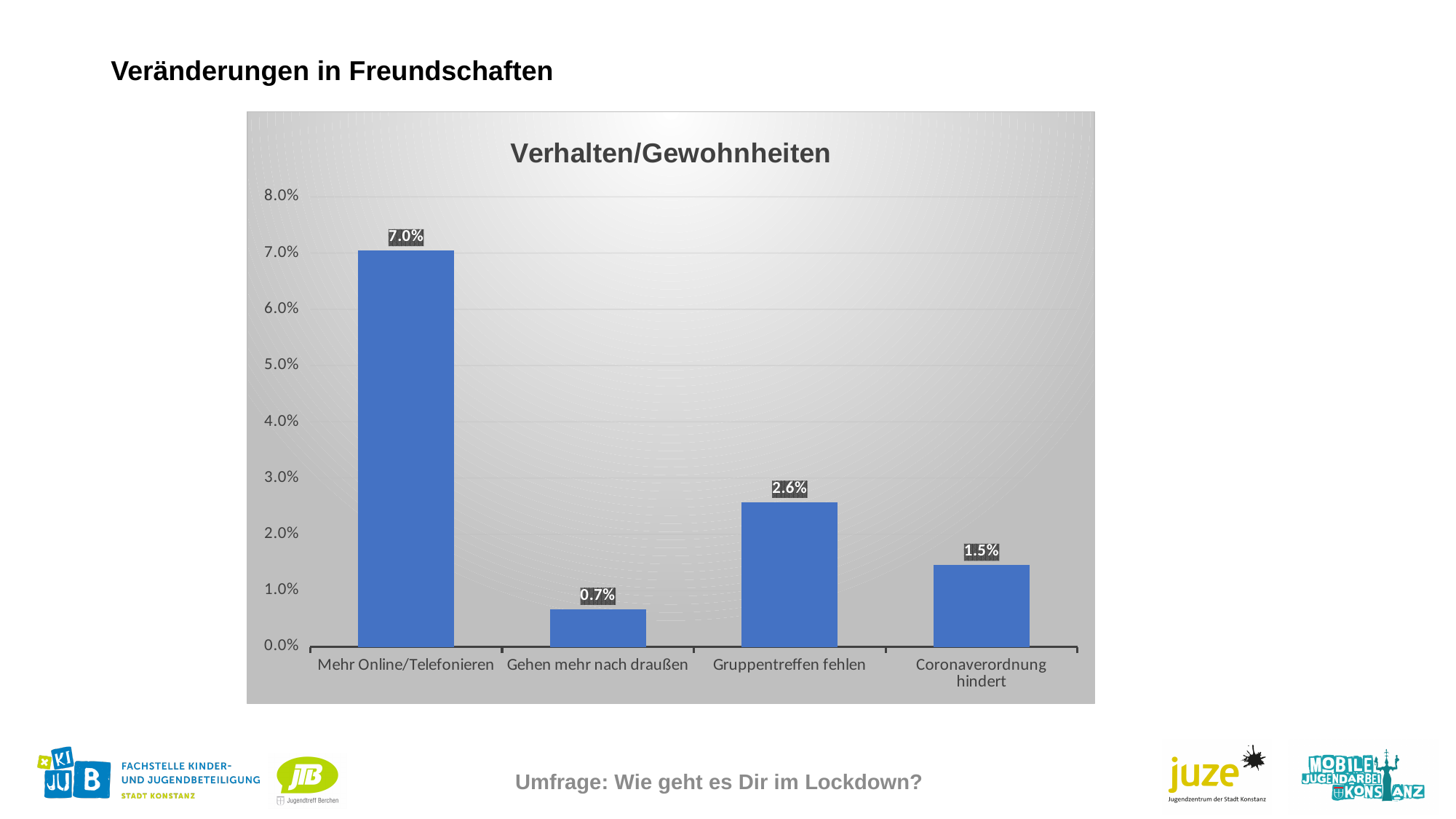
What is the title of the chart? Verhalten/Gewohnheiten What kind of chart is shown on the slide? bar chart Which category has the lowest value? Gehen mehr nach draußen Which is larger, the value for Gruppentreffen fehlen or the value for Coronaverordnung hindert? Gruppentreffen fehlen What is the value for Mehr Online/Telefonieren? 7.0% What is the value for Coronaverordnung hindert? 1.5% Which category has the highest value? Mehr Online/Telefonieren How many categories are shown on the x axis? 4 Is the value for Coronaverordnung hindert greater or less than 2.0%? less What is the value for Gruppentreffen fehlen? 2.6% What is the value for Gehen mehr nach draußen? 0.7% What is the difference between the values for Mehr Online/Telefonieren and Gruppentreffen fehlen? 4.4%